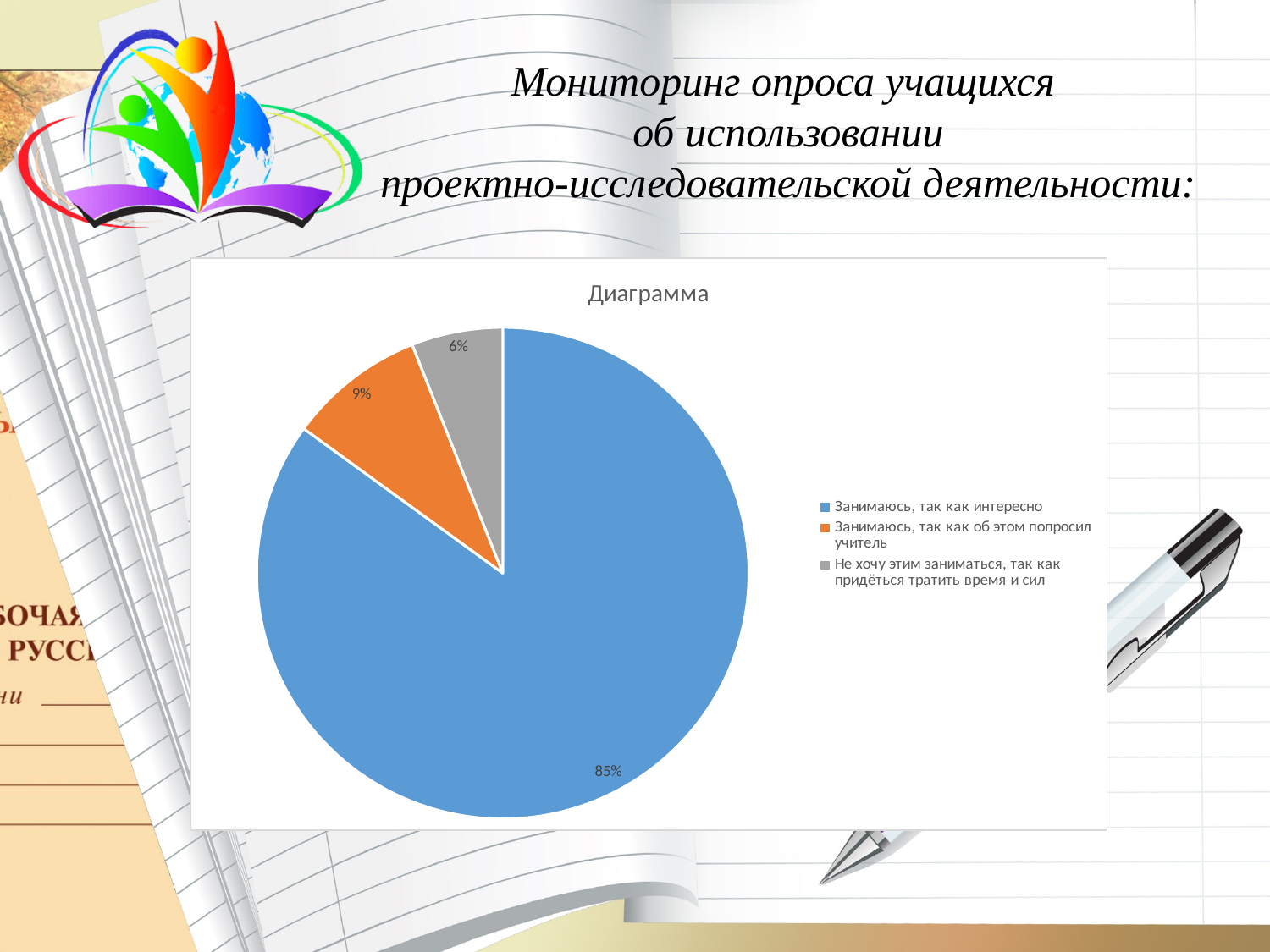
How many slices does the pie chart have? 3 What share of the pie is labelled "Занимаюсь, так как об этом попросил учитель"? 9% What kind of chart is shown on the slide? pie chart Which category has the largest slice of the pie? Занимаюсь, так как интересно Which is larger: the slice for "Занимаюсь, так как об этом попросил учитель" or the slice for "Не хочу этим заниматься, так как придёться тратить время и сил"? Занимаюсь, так как об этом попросил учитель Which category has the smallest slice of the pie? Не хочу этим заниматься, так как придёться тратить время и сил What share of the pie is labelled "Не хочу этим заниматься, так как придёться тратить время и сил"? 6% What is the difference in percentage points between the "Занимаюсь, так как интересно" slice and the "Занимаюсь, так как об этом попросил учитель" slice? 76% What is the difference in percentage points between the 9% slice and the 6% slice? 3% What colour is the slice for "Занимаюсь, так как интересно"? blue What is the title of the chart? Диаграмма What share of the pie is labelled "Занимаюсь, так как интересно"? 85%